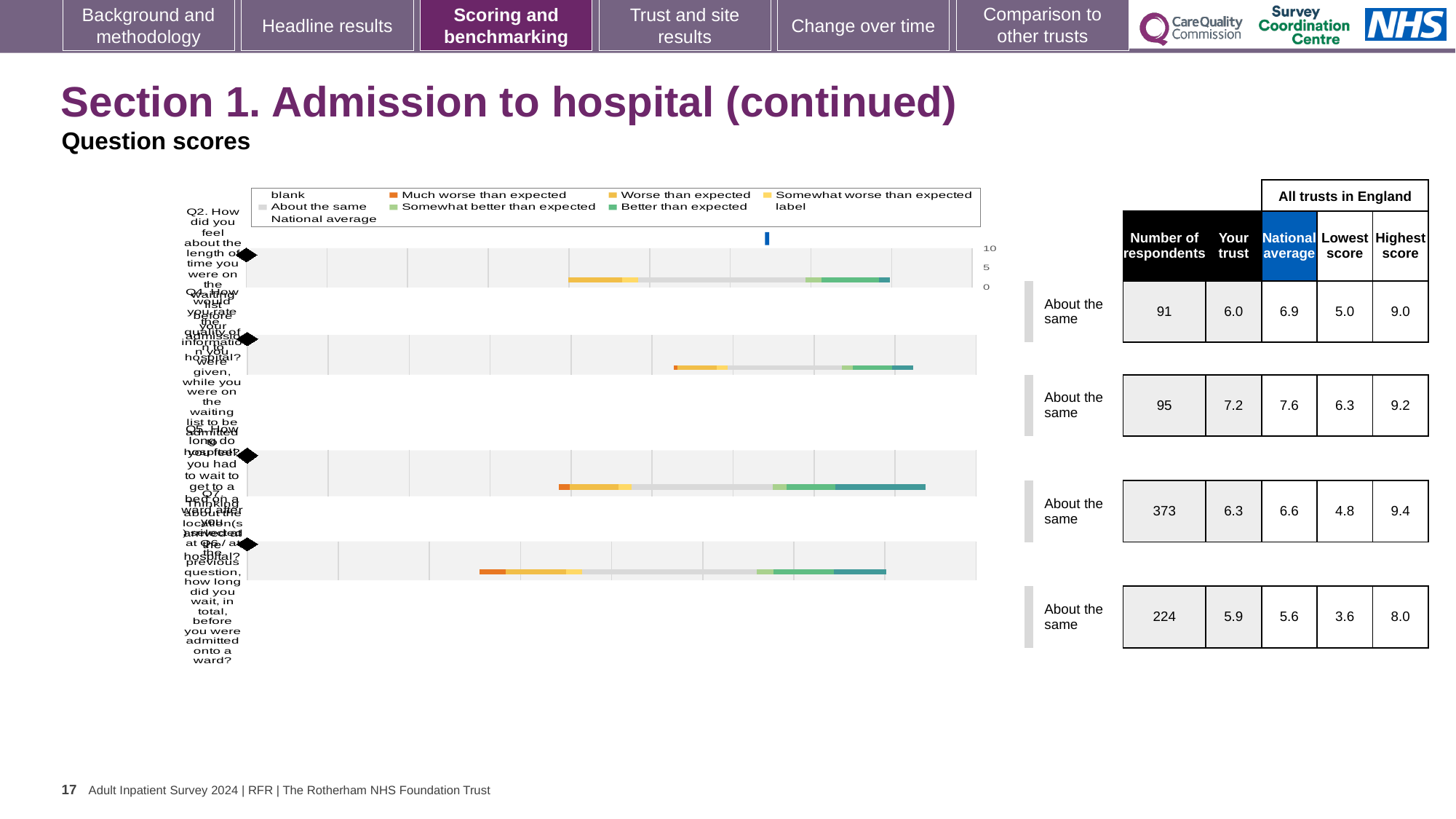
In the table, what is the national average for the third row (Q5)? 6.6 What kind of chart is shown on the slide? bar chart In the table, what is the difference between the highest score and the lowest score for the first row (Q2)? 4.0 What is the highest value shown on the chart's numeric axis? 10 In the table, for the fourth row (Q7), is the 'Your trust' score or the national average larger? Your trust (5.9) In the table, what is the lowest score for the fourth row (Q7)? 3.6 What benchmark category is shown for every question row on the slide? About the same In the table, what is the number of respondents for the first row (Q2)? 91 How many question rows (bars) are plotted in the chart? 4 In the table, what is the highest score for the third row (Q5)? 9.4 In the table, what is the 'Your trust' score for the second row (Q4)? 7.2 Which row in the table has the highest number of respondents? the third row (Q5), 373